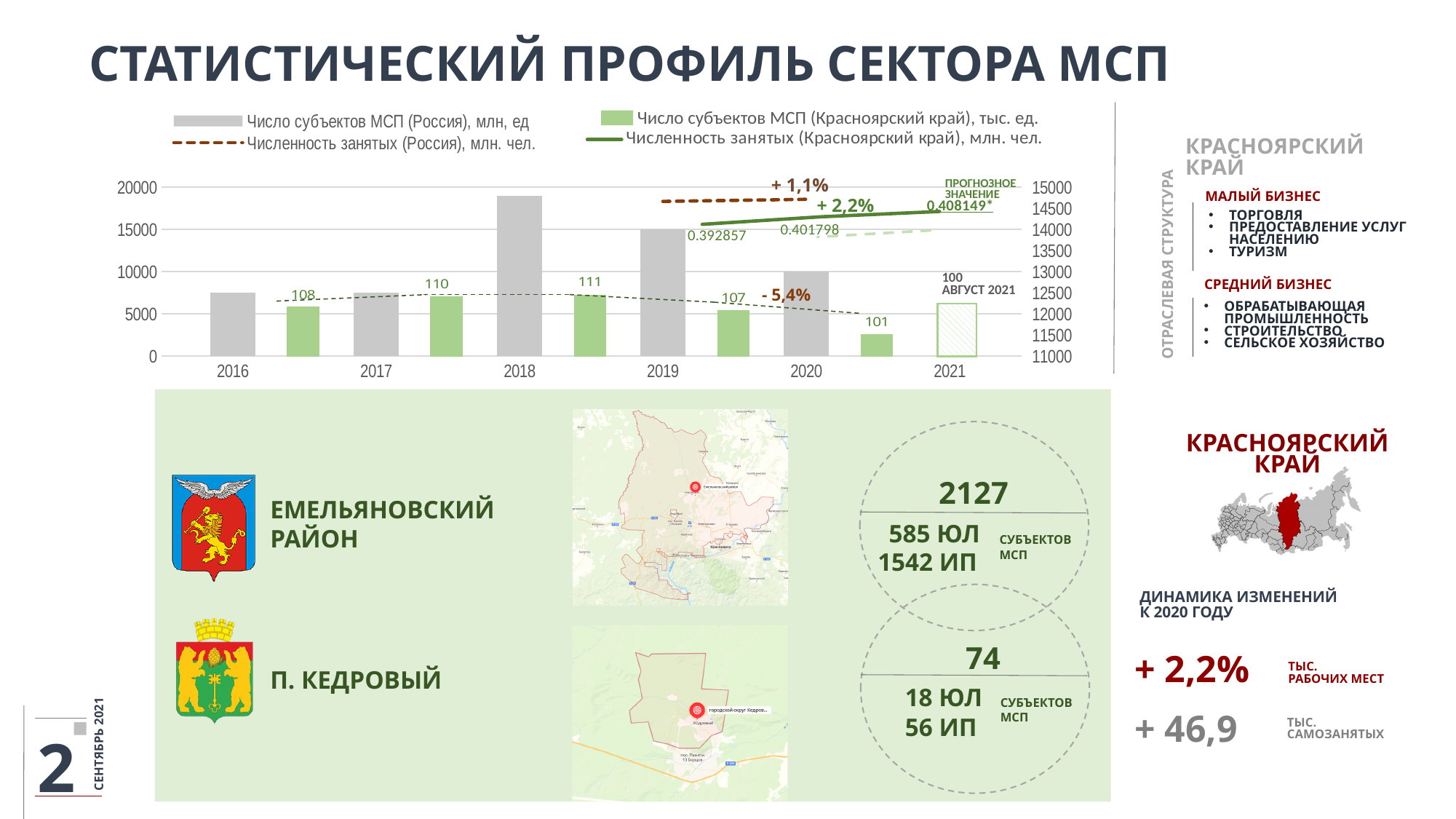
What is the labelled value of the employed population in Krasnoyarsk Krai (Численность занятых (Красноярский край)) for 2019? 0.392857 Which year has the larger labelled Krasnoyarsk Krai MSP value, 2017 or 2019? 2017 What is the value labelled for the number of MSP subjects in Krasnoyarsk Krai in 2020? 101 What is the value labelled for the number of MSP subjects in Krasnoyarsk Krai (Число субъектов МСП (Красноярский край)) in 2018? 111 In which year is the labelled number of MSP subjects in Krasnoyarsk Krai the lowest? 2021 Is the grey bar for Russia (Число субъектов МСП (Россия)) in 2018 greater or less than 15000 on the left axis? greater In which year is the labelled number of MSP subjects in Krasnoyarsk Krai the highest? 2018 What is the difference between the labelled Krasnoyarsk Krai MSP values for 2018 and 2020? 10 How many series does the chart legend list? 4 How many years are shown on the x axis of the chart? 6 Is the grey bar for Russia in 2016 greater or less than 10000 on the left axis? less What kind of chart is shown at the top of the slide? Combination bar and line chart